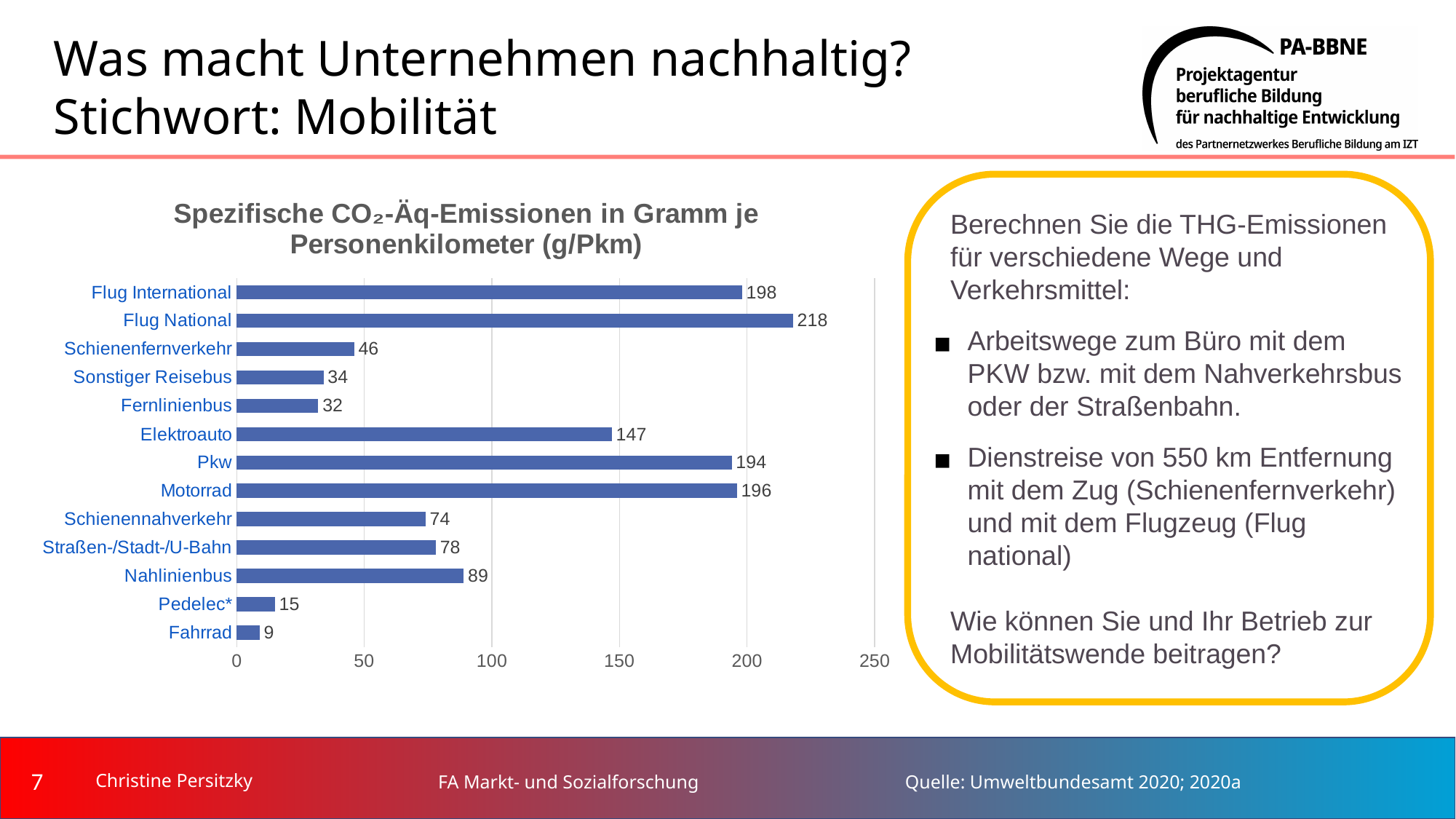
What is the difference between the values for Flug National and Schienenfernverkehr? 172 What is the difference between the values for Pkw and Elektroauto? 47 Which category has the lowest value? Fahrrad Which category has the highest value? Flug National What is the value for Nahlinienbus? 89 What is the title of the chart? Spezifische CO₂-Äq-Emissionen in Gramm je Personenkilometer (g/Pkm) What kind of chart is shown on the slide? bar chart Is the value for Motorrad greater or less than 150? greater Which is larger, the value for Schienennahverkehr or the value for Straßen-/Stadt-/U-Bahn? Straßen-/Stadt-/U-Bahn How many categories are shown in the chart? 13 What is the value for Elektroauto? 147 What is the value for Flug National? 218